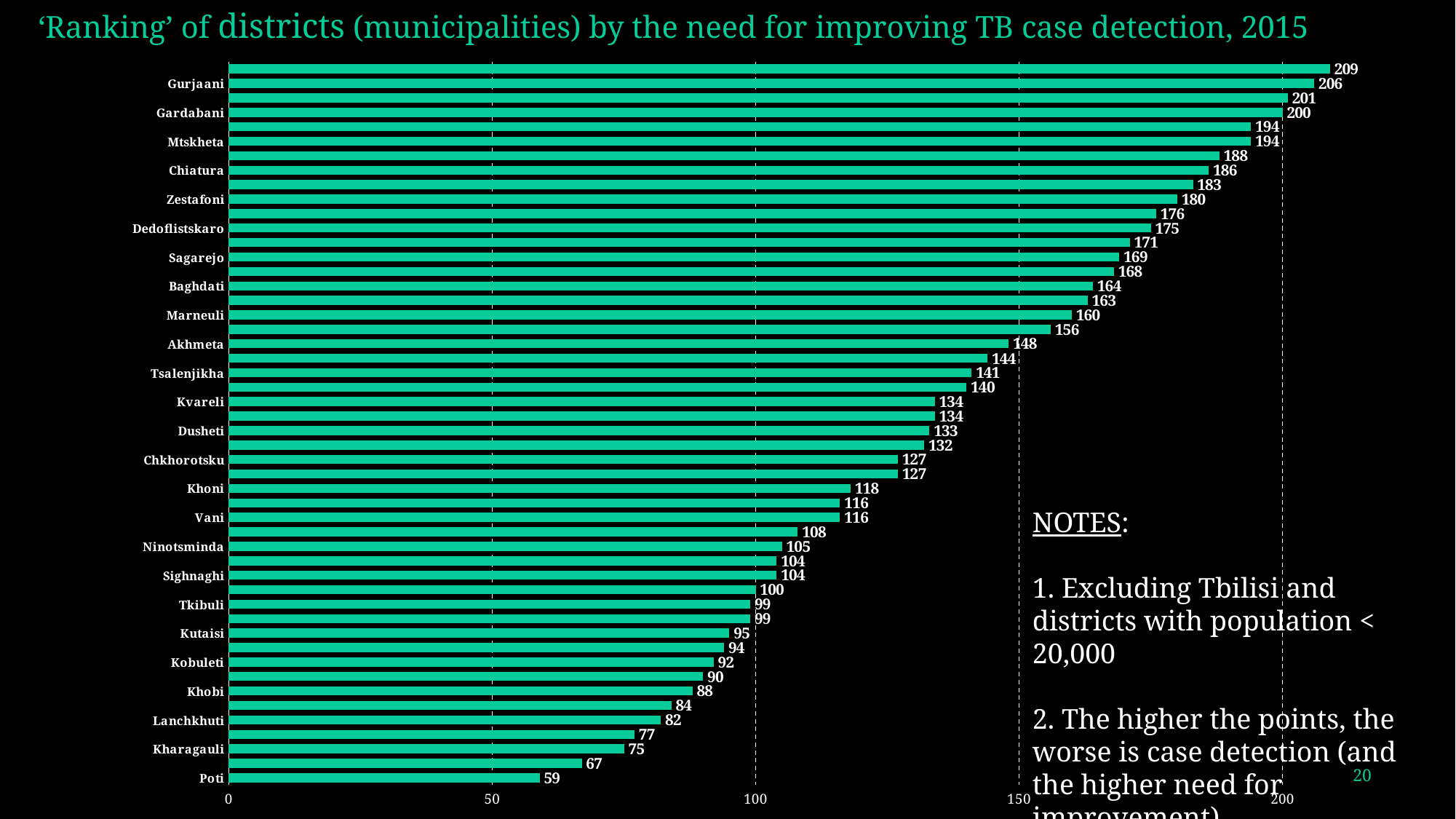
Which has a larger value, Khobi or Lanchkhuti? Khobi What is the value for Kutaisi? 95 What is the value for Gardabani? 200 What type of chart is shown on the slide? bar chart What is the title of the chart? 'Ranking' of districts (municipalities) by the need for improving TB case detection, 2015 Which labelled district has the lowest value? Poti What is the difference between the values for Gurjaani and Poti? 147 What is the value for Poti? 59 What is the highest value shown on the chart? 209 What is the value for Gurjaani? 206 What is the value for Marneuli? 160 Is the value for Tsalenjikha greater or less than 150? less